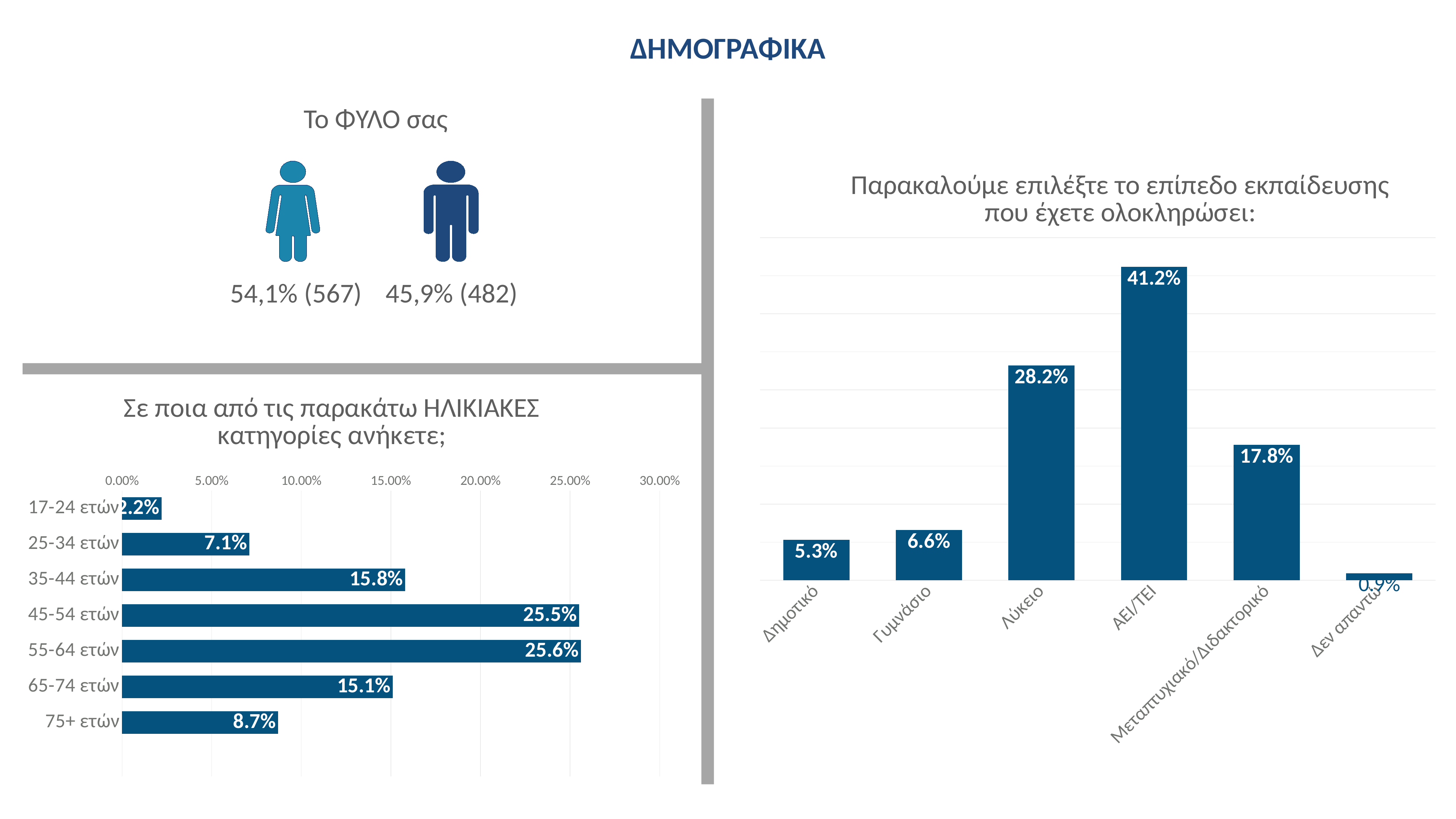
In the education level chart, how many categories are shown? 6 In the education level chart, which category has the highest value? ΑΕΙ/ΤΕΙ In the age categories chart, what is the value for 75+ ετών? 8.7% What kind of chart is the age categories chart? Bar chart In the age categories chart, which age category has the lowest value? 17-24 ετών In the education level chart, what is the value for Λύκειο? 28.2% In the age categories chart, what is the difference between the values for 35-44 ετών and 25-34 ετών? 8.7% In the education level chart, which category has the lowest value? Δεν απαντώ In the age categories chart, which is larger: the value for 65-74 ετών or the value for 75+ ετών? 65-74 ετών In the age categories chart, what is the value for 35-44 ετών? 15.8% In the education level chart, what is the difference between the values for ΑΕΙ/ΤΕΙ and Μεταπτυχιακό/Διδακτορικό? 23.4% In the age categories chart, how many age categories are shown? 7